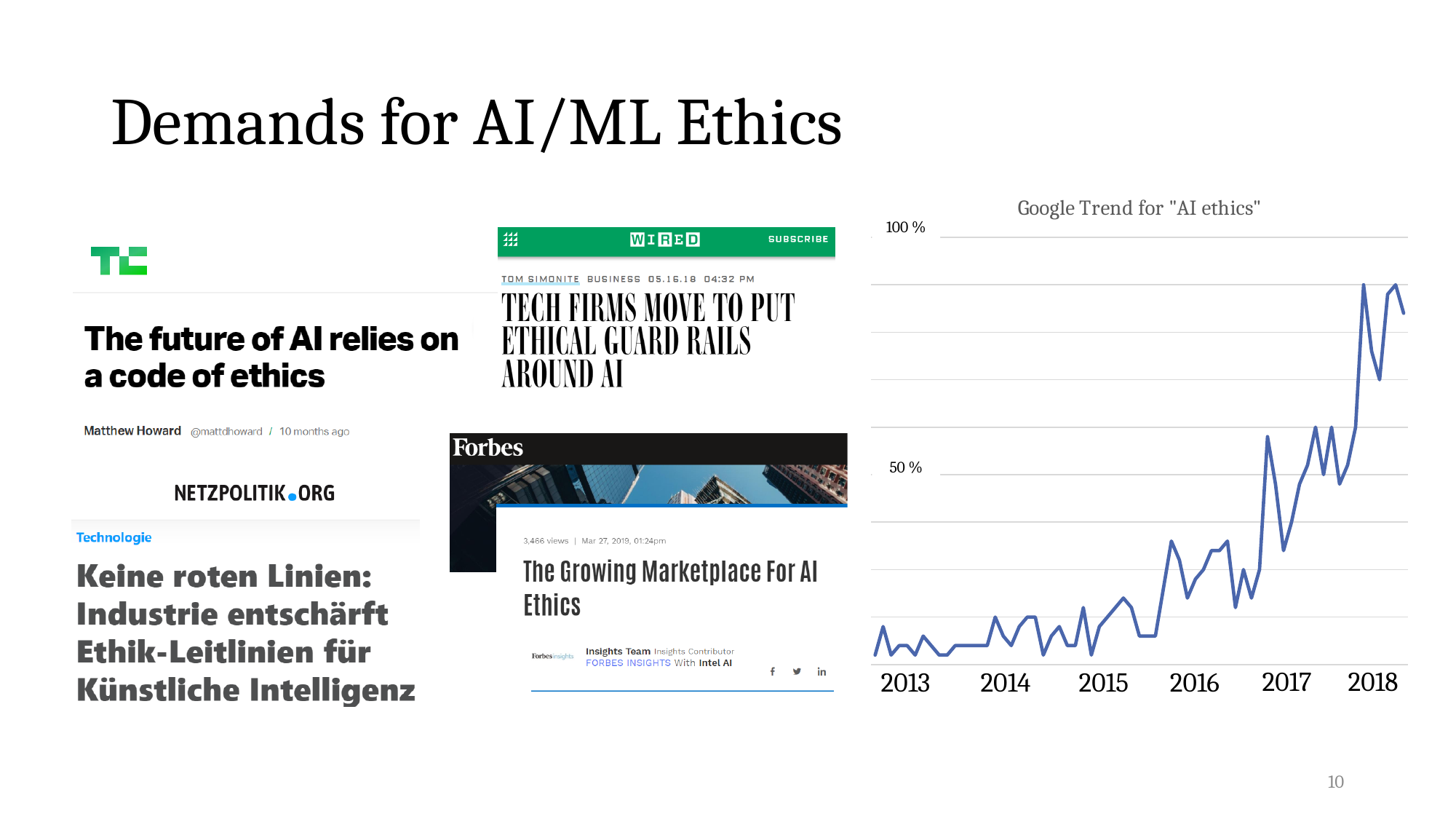
Which is larger in the Google Trend chart, the value at 2014 or the value at 2018? 2018 What is the title of the chart on the slide? Google Trend for "AI ethics" Is the value at 2015 in the Google Trend chart greater or less than 50%? less Is the value at 2018 in the Google Trend chart greater or less than 50%? greater Is the peak value in the Google Trend chart greater or less than 50%? greater What is the first year labelled on the x axis of the Google Trend chart? 2013 Which is larger in the Google Trend chart, the value at 2013 or the value at 2017? 2017 Overall, do the values in the Google Trend chart rise or fall from 2013 to 2018? rise How many years are labelled on the x axis of the Google Trend chart? 6 Which year on the x axis of the Google Trend chart has the highest value? 2018 What kind of chart is shown on the right of the slide? line chart